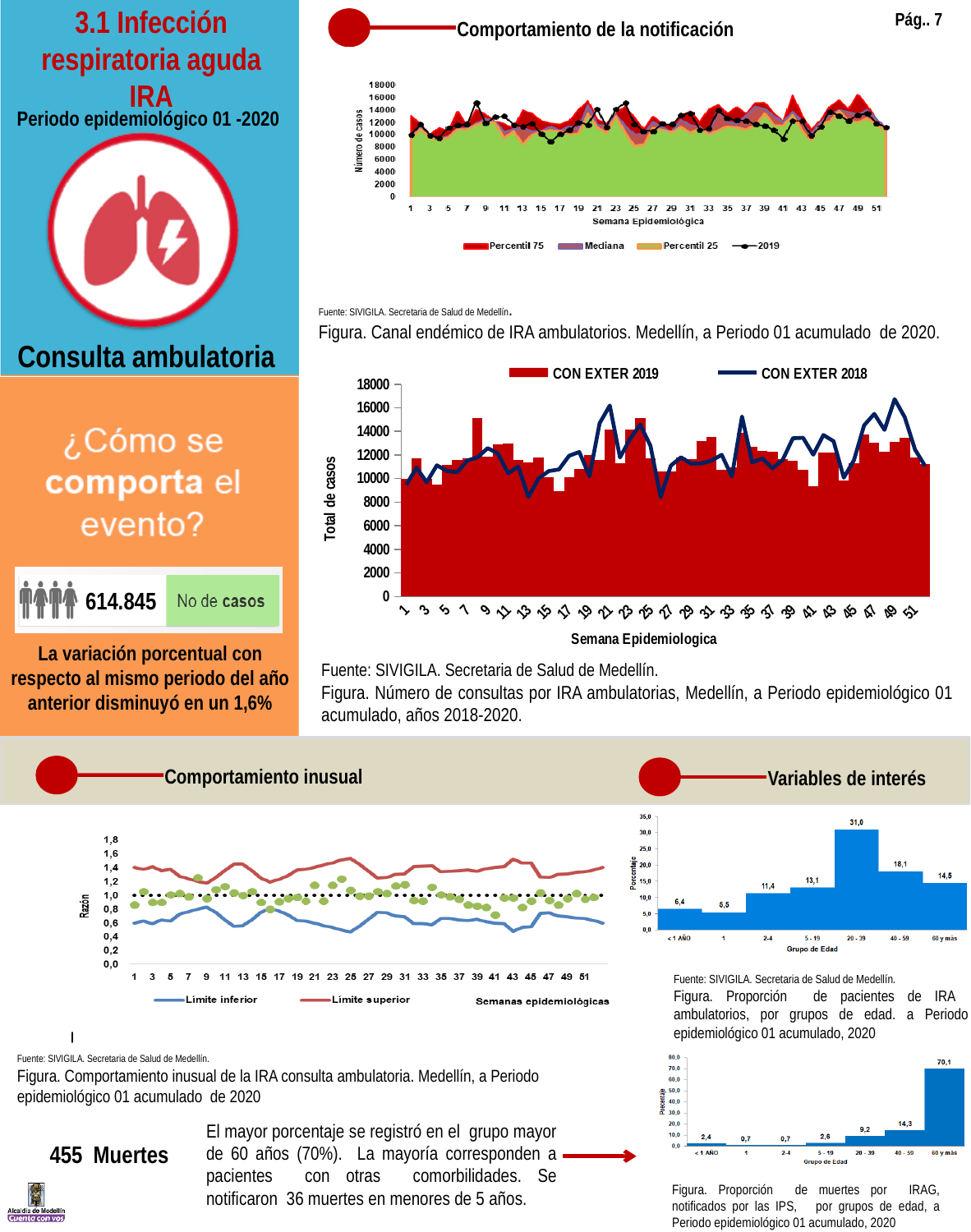
In the chart of proportion of deaths by IRAG by age group (Variables de interés, lower chart), what is the value for the 60 y más group? 70,1 In the chart of proportion of deaths by IRAG by age group (Variables de interés, lower chart), what is the value for the 5 - 19 group? 2,6 In the chart of proportion of deaths by IRAG by age group (Variables de interés, lower chart), which is larger: the value for 20 - 39 or for 40 - 59? 40 - 59 In the chart of proportion of deaths by IRAG by age group (Variables de interés, lower chart), what is the difference between the < 1 AÑO and 1 groups? 1,7 In the chart of proportion of IRA ambulatory patients by age group (Variables de interés, upper chart), what is the difference between the 40 - 59 and 60 y más groups? 3,6 In the chart of proportion of IRA ambulatory patients by age group (Variables de interés, upper chart), which age group has the lowest percentage? 1 What type of chart is used for the proportion of IRA ambulatory patients by age group (Variables de interés, upper chart)? Bar chart How many series does the legend of the Canal endémico de IRA ambulatorios chart (top right) list? 4 In the chart of number of IRA ambulatory consultations by epidemiological week (middle right), which series is drawn as bars? CON EXTER 2019 In the chart of proportion of IRA ambulatory patients by age group (Variables de interés, upper chart), how many age groups are shown? 7 In the chart of proportion of deaths by IRAG by age group (Variables de interés, lower chart), which age group has the highest percentage? 60 y más In the chart of proportion of IRA ambulatory patients by age group (Variables de interés, upper chart), what is the value for the 20 - 39 age group? 31,0